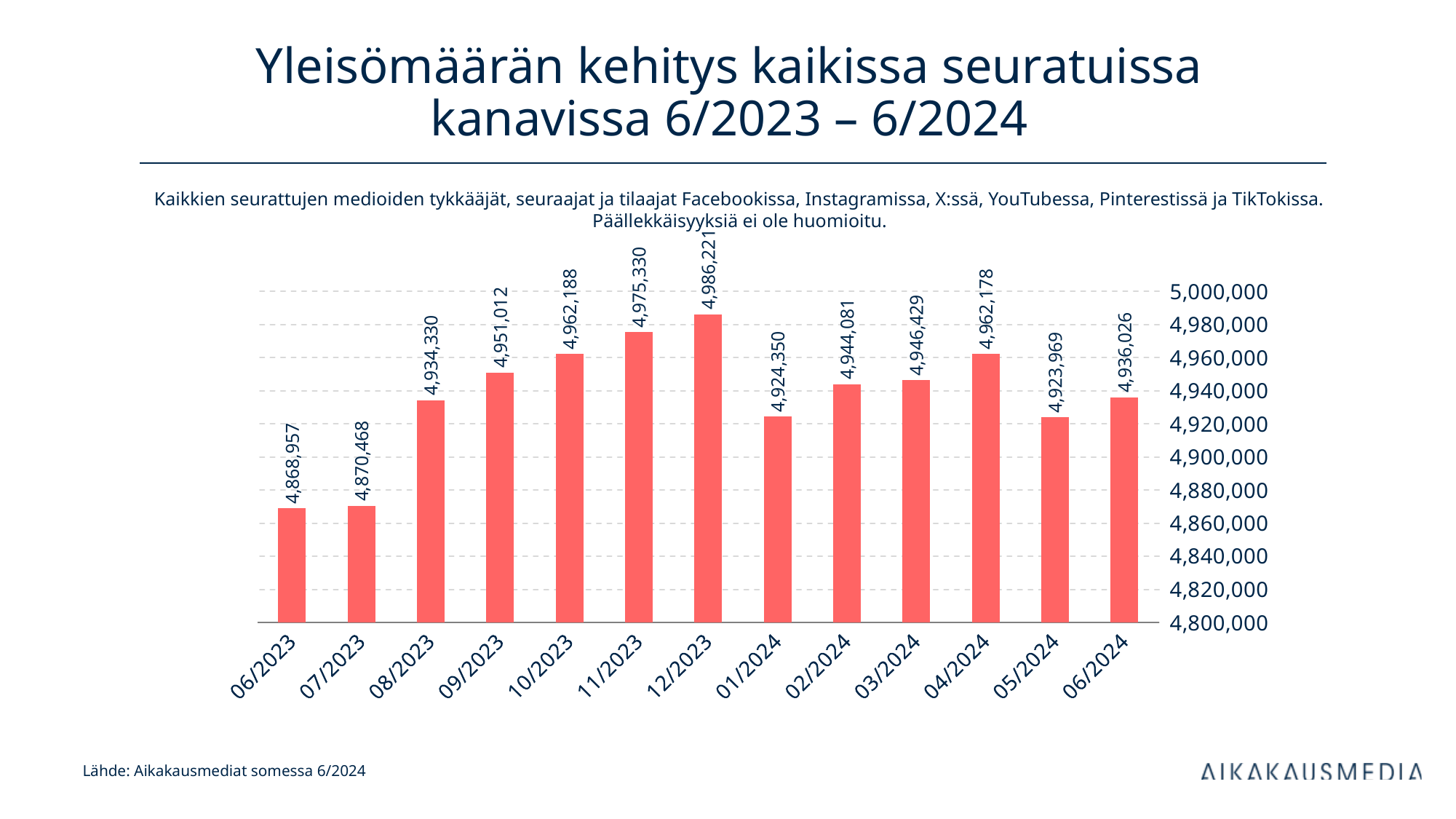
What is the value for 01/2024? 4,924,350 Which month has the highest value? 12/2023 What is the difference between the values for 06/2024 and 06/2023? 67,069 What is the difference between the values for 12/2023 and 06/2023? 117,264 What is the value for 12/2023? 4,986,221 What kind of chart is shown on the slide? bar chart Which month has the lowest value? 06/2023 What is the value for 06/2024? 4,936,026 Which is larger, the value for 09/2023 or the value for 02/2024? 09/2023 Do the values rise or fall from 06/2023 to 12/2023? rise Is the value for 11/2023 greater or less than 4,960,000? greater How many months are shown on the x axis? 13